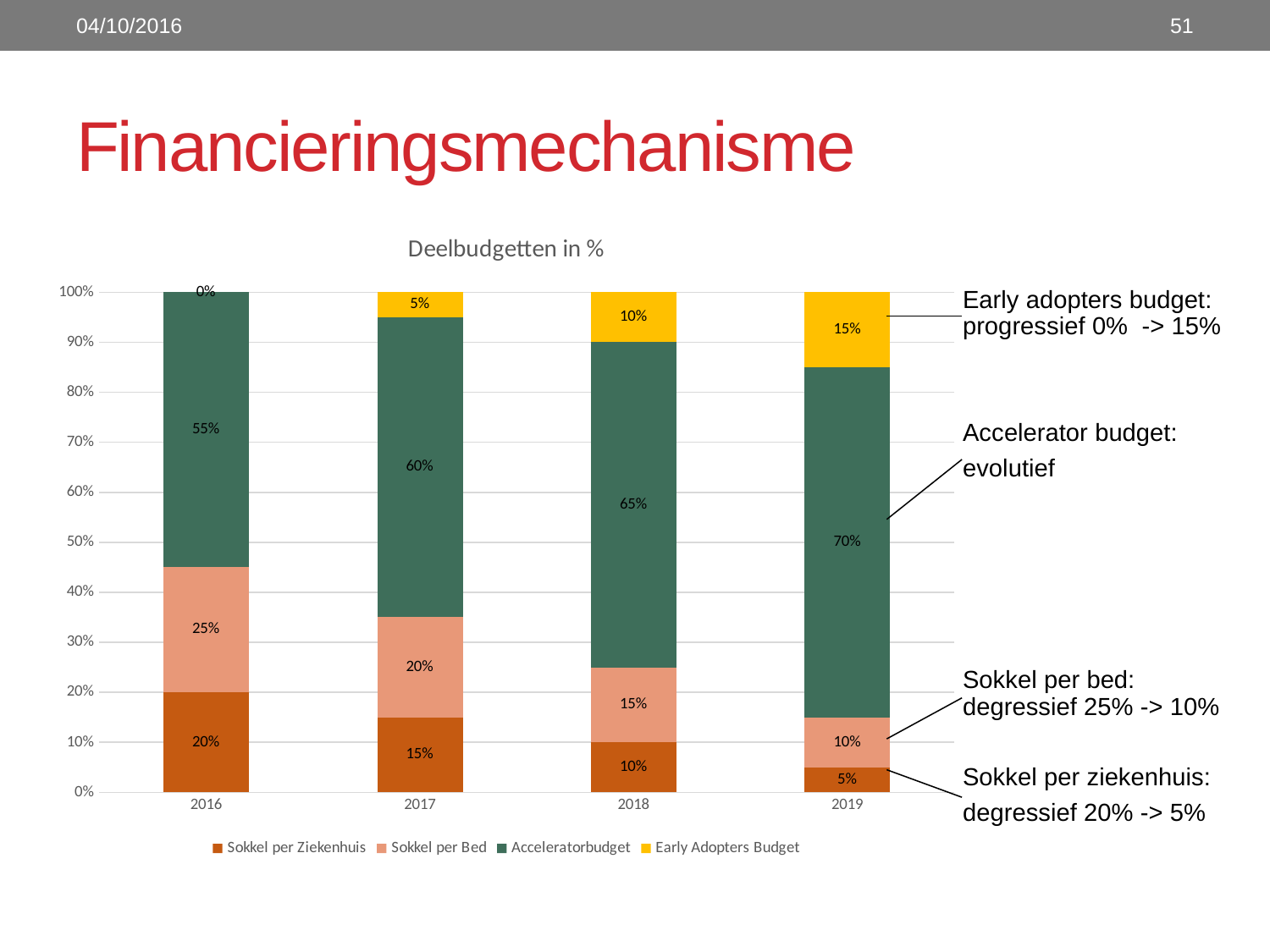
In which year is the Acceleratorbudget share highest? 2019 What kind of chart is this? Stacked bar chart What is the value for Early Adopters Budget in 2019? 15% In which year is the Sokkel per Ziekenhuis share lowest? 2019 Which is larger in 2017: Sokkel per Bed or Early Adopters Budget? Sokkel per Bed How many series does the legend list? 4 Does the Early Adopters Budget share rise or fall from 2016 to 2019? Rise What is the value for Acceleratorbudget in 2018? 65% How many years are shown on the x axis? 4 What is the difference between the Acceleratorbudget value in 2019 and in 2016? 15% What is the value for Sokkel per Bed in 2017? 20% What is the value for Sokkel per Ziekenhuis in 2016? 20%